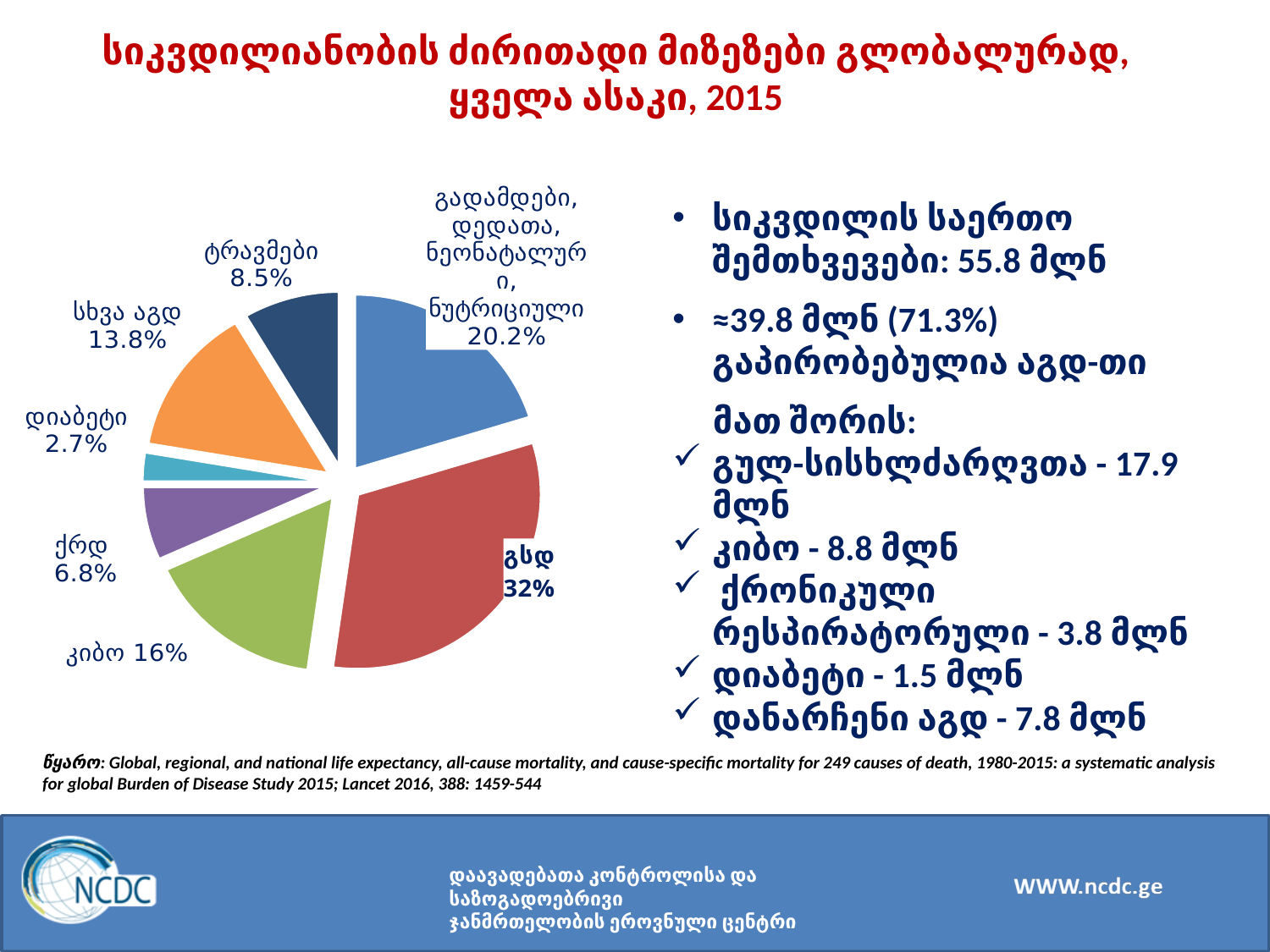
How many slices does the pie chart have? 7 What percentage does the pie chart show for დიაბეტი? 2.7% Which category has the smallest share of the pie chart? დიაბეტი What percentage does the pie chart show for სხვა აგდ? 13.8% What percentage does the pie chart show for გსდ? 32% What colour is the გსდ slice in the pie chart? red What is the difference in percentage points between გსდ and კიბო in the pie chart? 16 What percentage does the pie chart show for კიბო? 16% Which category has the largest share of the pie chart? გსდ What percentage does the pie chart show for ტრავმები? 8.5% Which has a larger share in the pie chart, ქრდ or ტრავმები? ტრავმები What type of chart is shown on the slide? pie chart